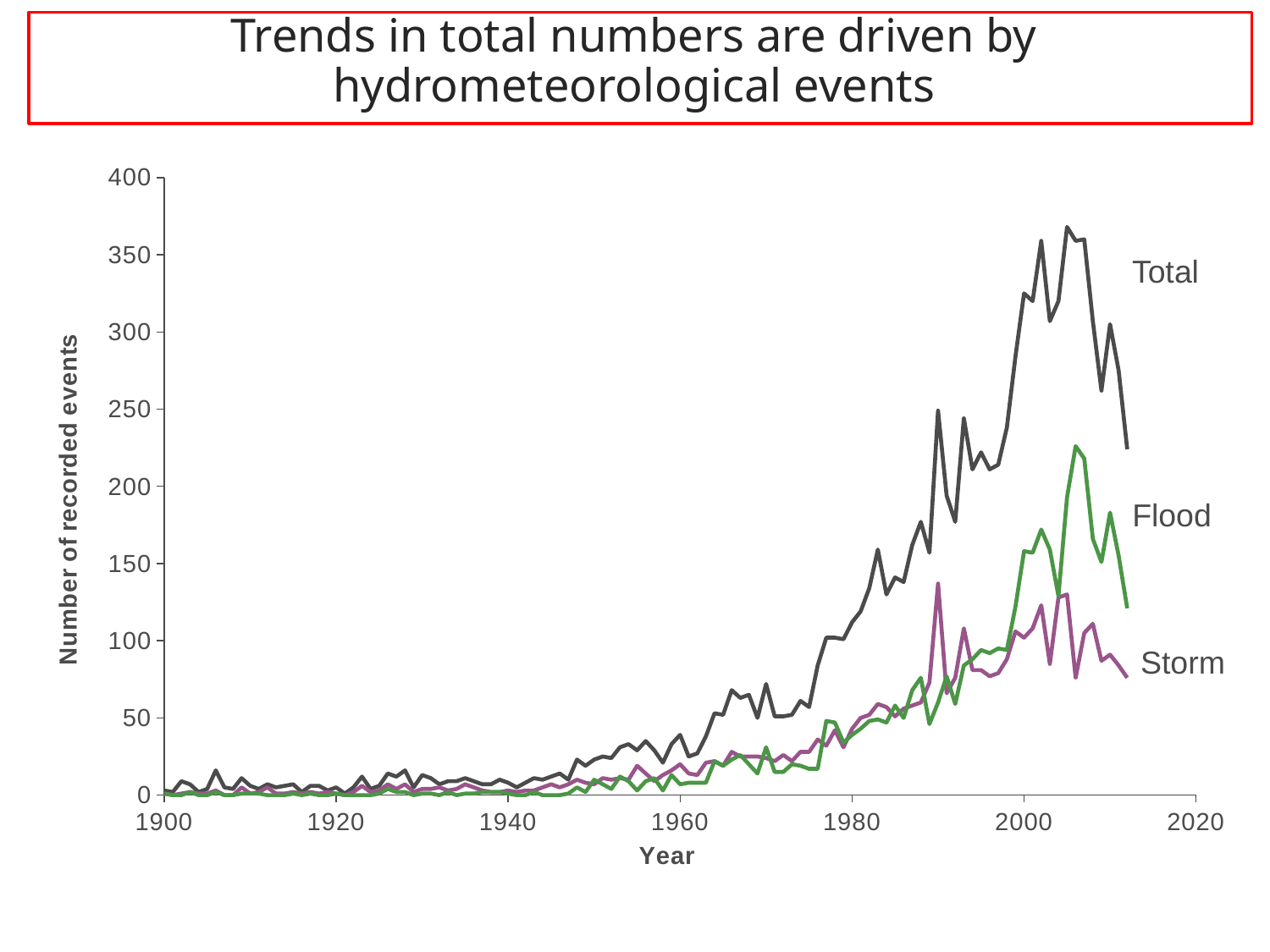
Is the peak value of the Total series greater or less than 350? greater Is the value of the Total series in 1960 greater or less than 50? less Which series reaches the highest value on the chart? Total Which series has the lowest values around the year 2010? Storm Does the Total series generally rise or fall from 1900 to 2000? rise Is the peak value of the Flood series greater or less than 200? greater Around 2006, which series has the larger value, Flood or Storm? Flood What is the label of the y axis? Number of recorded events How many series are plotted on the chart? 3 What kind of chart is shown on the slide? line chart